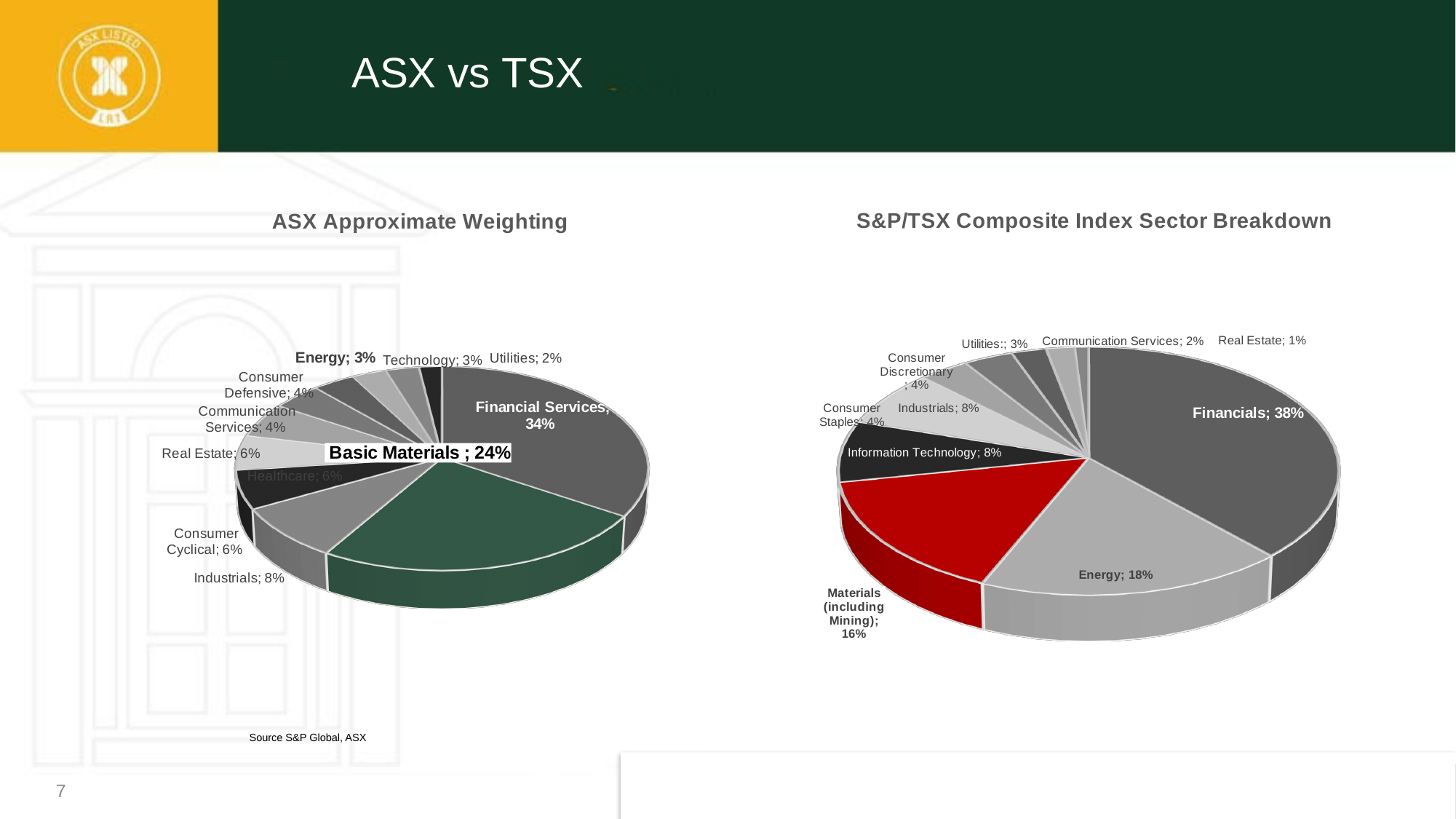
In the S&P/TSX Composite Index Sector Breakdown chart, what share does Materials (including Mining) have? 16% In the S&P/TSX Composite Index Sector Breakdown chart, what share does Energy have? 18% Which is larger: Industrials in the ASX Approximate Weighting chart or Industrials in the S&P/TSX Composite Index Sector Breakdown chart? They are equal (8%) In the S&P/TSX Composite Index Sector Breakdown chart, which sector has the largest share? Financials In the ASX Approximate Weighting chart, what is the weighting of Financial Services? 34% In the S&P/TSX Composite Index Sector Breakdown chart, which sector has the smallest share? Real Estate What type of chart is the S&P/TSX Composite Index Sector Breakdown chart? Pie chart In the ASX Approximate Weighting chart, what is the weighting of Basic Materials? 24% In the S&P/TSX Composite Index Sector Breakdown chart, what is the difference between the Financials and Energy shares? 20% In the ASX Approximate Weighting chart, what is the difference between the Financial Services and Basic Materials weightings? 10% How many sectors are shown in the ASX Approximate Weighting chart? 11 In the ASX Approximate Weighting chart, which sector has the smallest weighting? Utilities